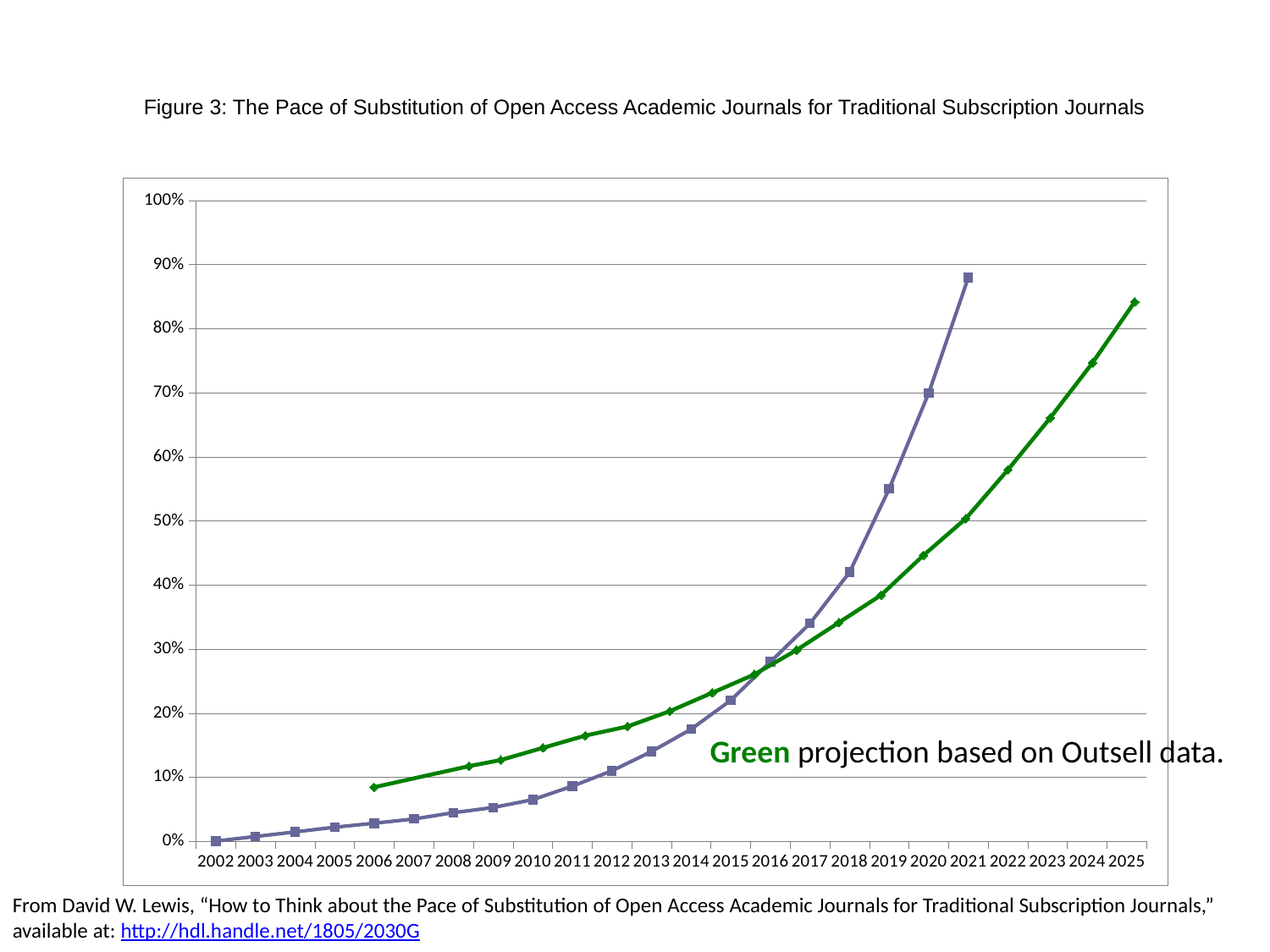
How many years are labelled along the x axis? 24 Is the value of the green line in 2025 greater or less than 80%? greater How many lines are plotted on the chart? 2 Is the value of the purple line in 2021 greater or less than 80%? greater Is the value of the purple line in 2019 greater or less than 50%? greater What is the title of the figure on the slide? Figure 3: The Pace of Substitution of Open Access Academic Journals for Traditional Subscription Journals In 2021, which line has the higher value, the purple line or the green line? Purple line What kind of chart is shown on the slide? Line chart In 2010, which line has the higher value, the purple line or the green line? Green line Which colour line is the projection based on Outsell data? Green Do the values of the purple line rise or fall from 2002 to 2021? Rise